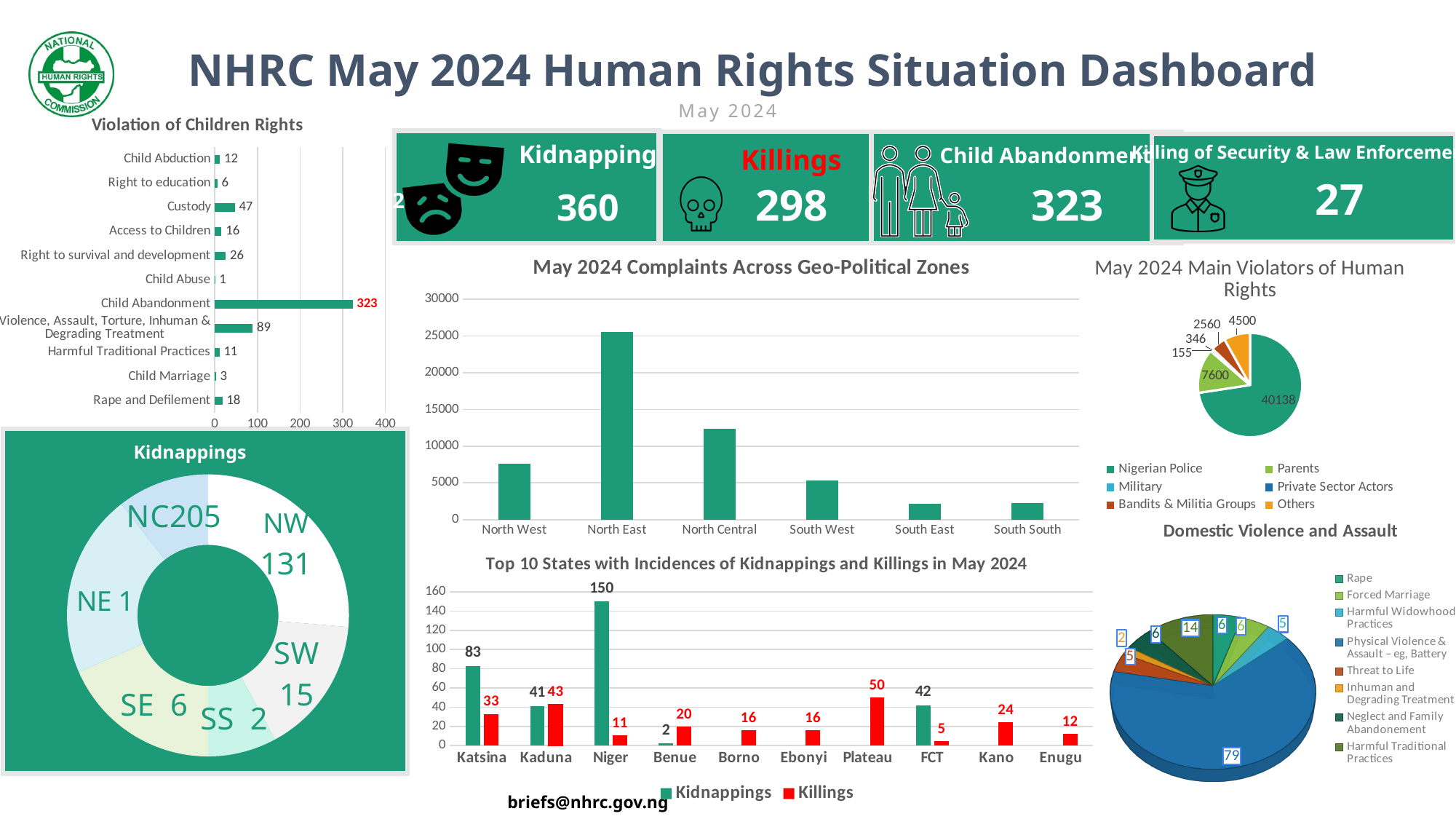
In the Violation of Children Rights chart, what is the value for Custody? 47 In the Kidnappings donut chart, what is the value for NC? 205 In the May 2024 Complaints Across Geo-Political Zones chart, which zone has the highest number of complaints? North East In the May 2024 Main Violators of Human Rights pie chart, what is the value for Nigerian Police? 40138 How many categories are shown in the Violation of Children Rights chart? 11 In the Top 10 States chart, which is larger in Kaduna, Kidnappings or Killings? Killings In the Kidnappings donut chart, which is larger, SW or SE? SW In the May 2024 Complaints Across Geo-Political Zones chart, is the value for North Central greater or less than 10000? greater How many series does the legend of the Top 10 States with Incidences of Kidnappings and Killings chart list? 2 In the Top 10 States chart, what is the number of Kidnappings in Niger? 150 In the Violation of Children Rights chart, what is the difference between Child Abandonment and Violence, Assault, Torture, Inhuman & Degrading Treatment? 234 In the Violation of Children Rights chart, which category has the highest value? Child Abandonment